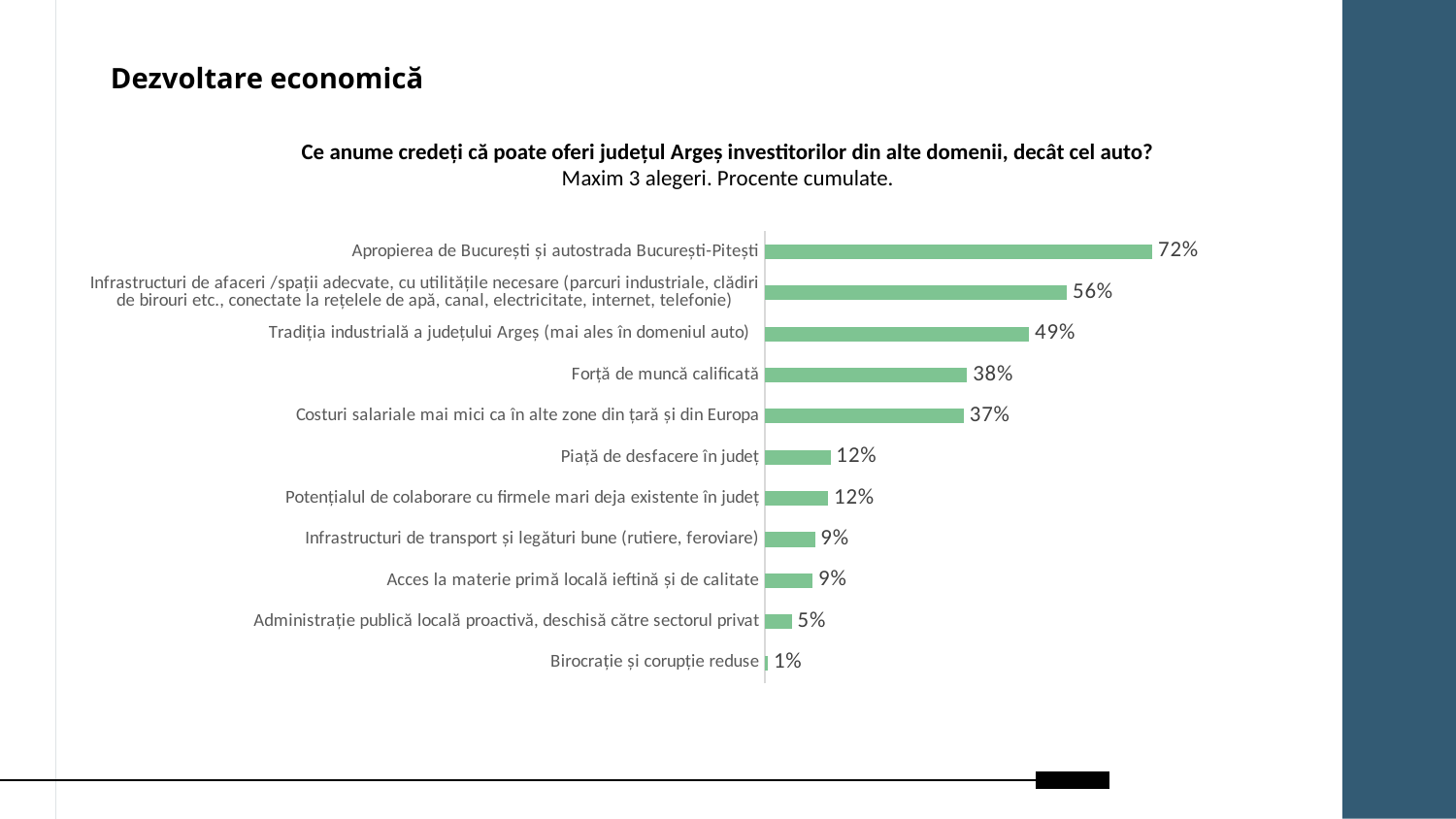
What is the difference between the values for "Forță de muncă calificată" and "Costuri salariale mai mici ca în alte zone din țară și din Europa"? 1% What is the value for "Piață de desfacere în județ"? 12% What is the value for "Forță de muncă calificată"? 38% Which category has the highest value? Apropierea de București și autostrada București-Pitești Which is larger: the value for "Tradiția industrială a județului Argeș (mai ales în domeniul auto)" or for "Costuri salariale mai mici ca în alte zone din țară și din Europa"? Tradiția industrială a județului Argeș (mai ales în domeniul auto) How many categories are shown in the chart? 11 What is the difference between the values for "Apropierea de București și autostrada București-Pitești" and "Tradiția industrială a județului Argeș (mai ales în domeniul auto)"? 23% Which category has the lowest value? Birocrație și corupție reduse What is the value for "Apropierea de București și autostrada București-Pitești"? 72% What kind of chart is shown on the slide? Bar chart What is the value for "Administrație publică locală proactivă, deschisă către sectorul privat"? 5% What question is the chart based on, according to the chart title? Ce anume credeți că poate oferi județul Argeș investitorilor din alte domenii, decât cel auto?